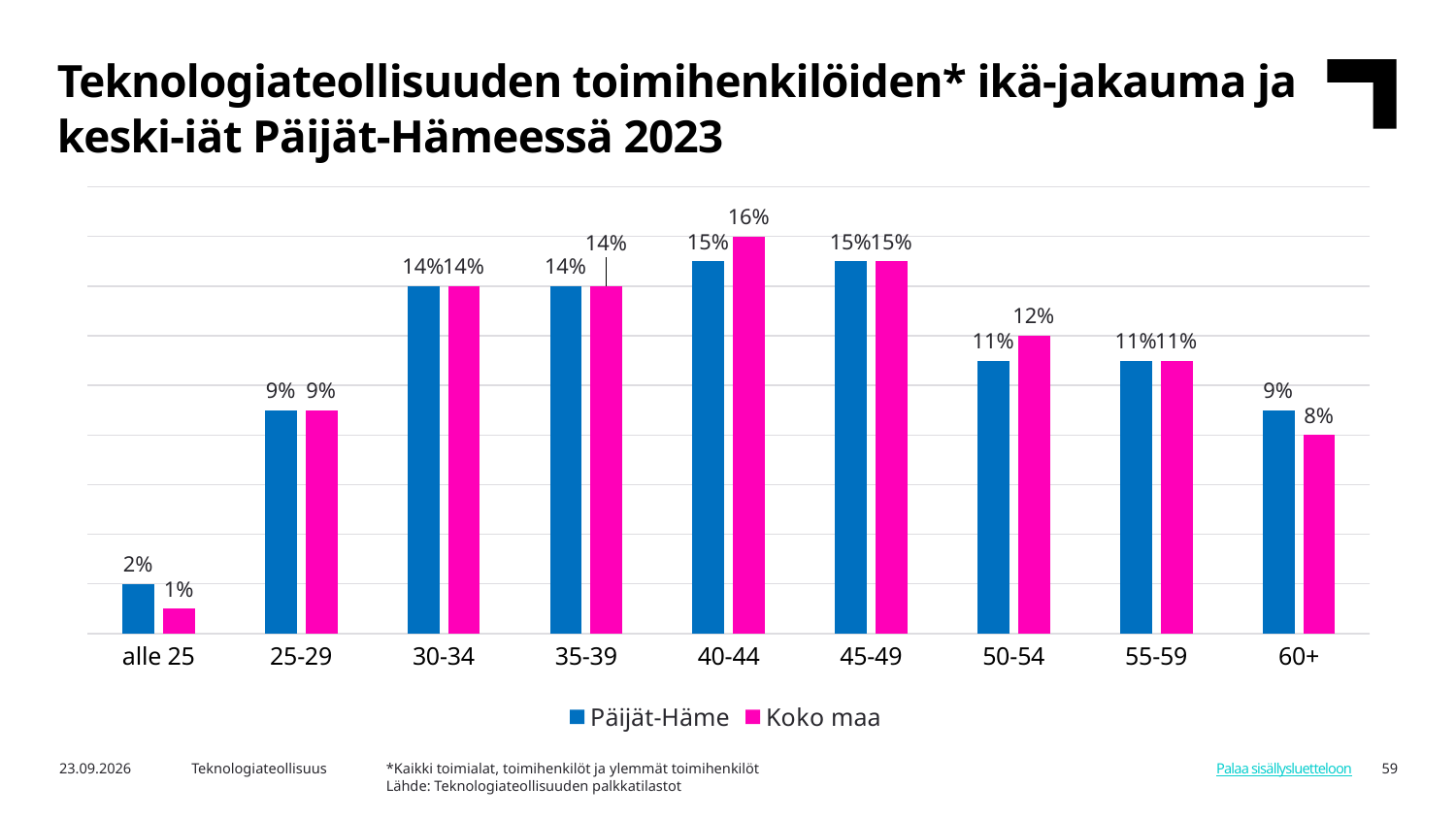
What is the value for Koko maa in the 60+ category? 8% What kind of chart is shown on the slide? bar chart Which age category has the lowest value for Päijät-Häme? alle 25 What is the value for Päijät-Häme in the 'alle 25' category? 2% How many series does the legend list? 2 What is the value for Päijät-Häme in the 50-54 category? 11% Which series is shown in pink in the legend? Koko maa Which age category has the highest value for Koko maa? 40-44 What is the difference between the Koko maa and Päijät-Häme values in the 50-54 category? 1% What is the value for Koko maa in the 40-44 category? 16% In the 60+ category, which series has the larger value, Päijät-Häme or Koko maa? Päijät-Häme How many age categories are shown on the x axis? 9